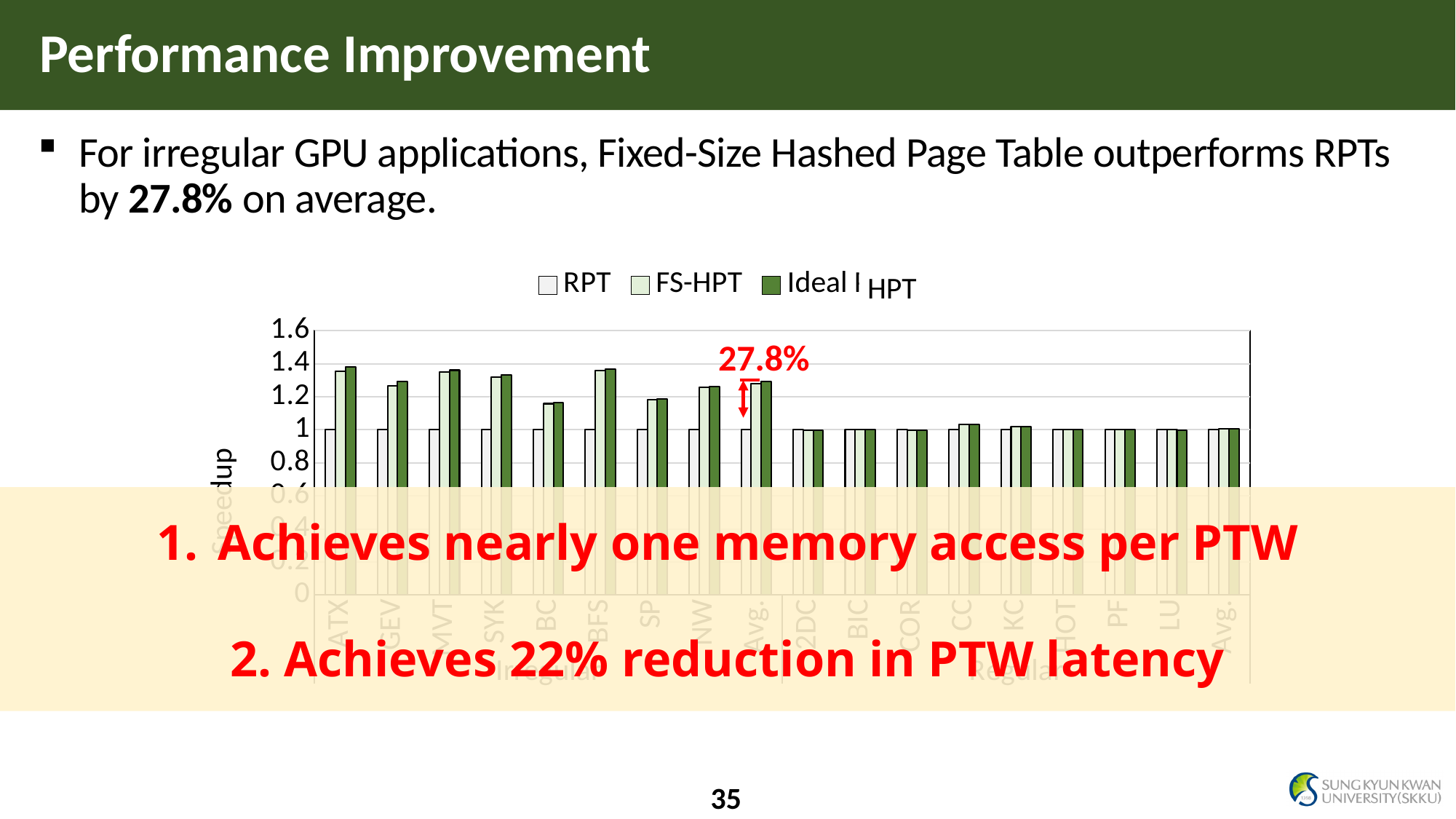
For NW, which series has the larger speedup, RPT or FS-HPT? FS-HPT What kind of chart is shown on the slide? bar chart Is the FS-HPT speedup for ATX greater or less than 1.2? greater What are the three series named in the chart's legend? RPT, FS-HPT, Ideal HPT Is the FS-HPT speedup for 2DC greater or less than 1.2? less Is the Ideal HPT speedup for BC greater or less than 1.4? less What percentage improvement is annotated above the irregular Avg. bars in the chart? 27.8% What is the label on the chart's y axis? Speedup How many series does the chart's legend list? 3 Which has the larger FS-HPT speedup, ATX or BC? ATX What is the highest tick value shown on the chart's y axis? 1.6